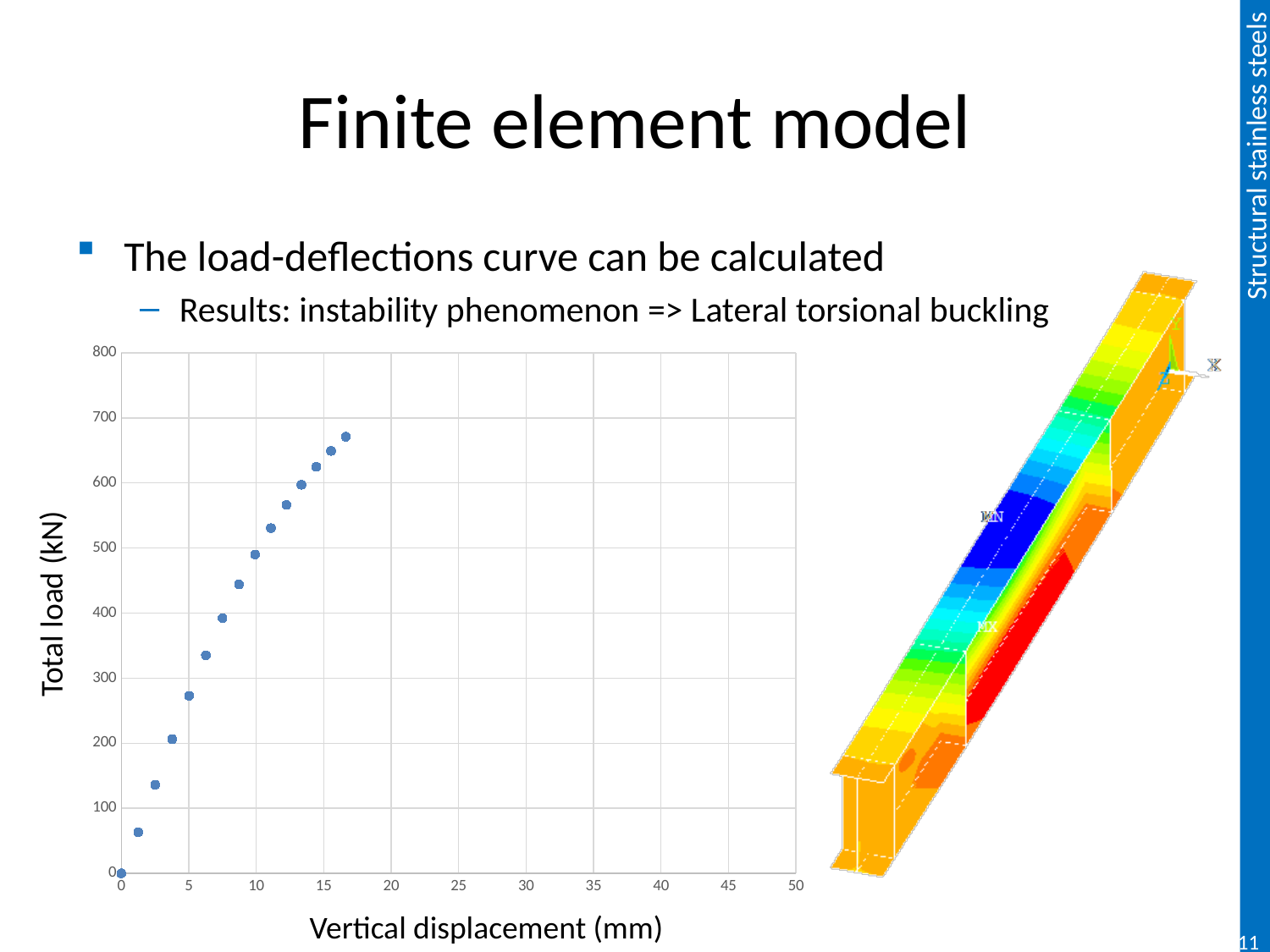
Do the plotted values of total load rise or fall as vertical displacement increases? rise Is the total load at a vertical displacement of about 10 mm greater or less than 400 kN? greater Is the total load of the highest plotted point greater or less than 700 kN? less How many data points are plotted on the chart? 15 Is the vertical displacement of the last plotted point greater or less than 20 mm? less What kind of chart is shown on the slide? scatter chart What is the label of the vertical axis of the chart? Total load (kN) What is the maximum value shown on the horizontal axis of the chart? 50 What is the label of the horizontal axis of the chart? Vertical displacement (mm)